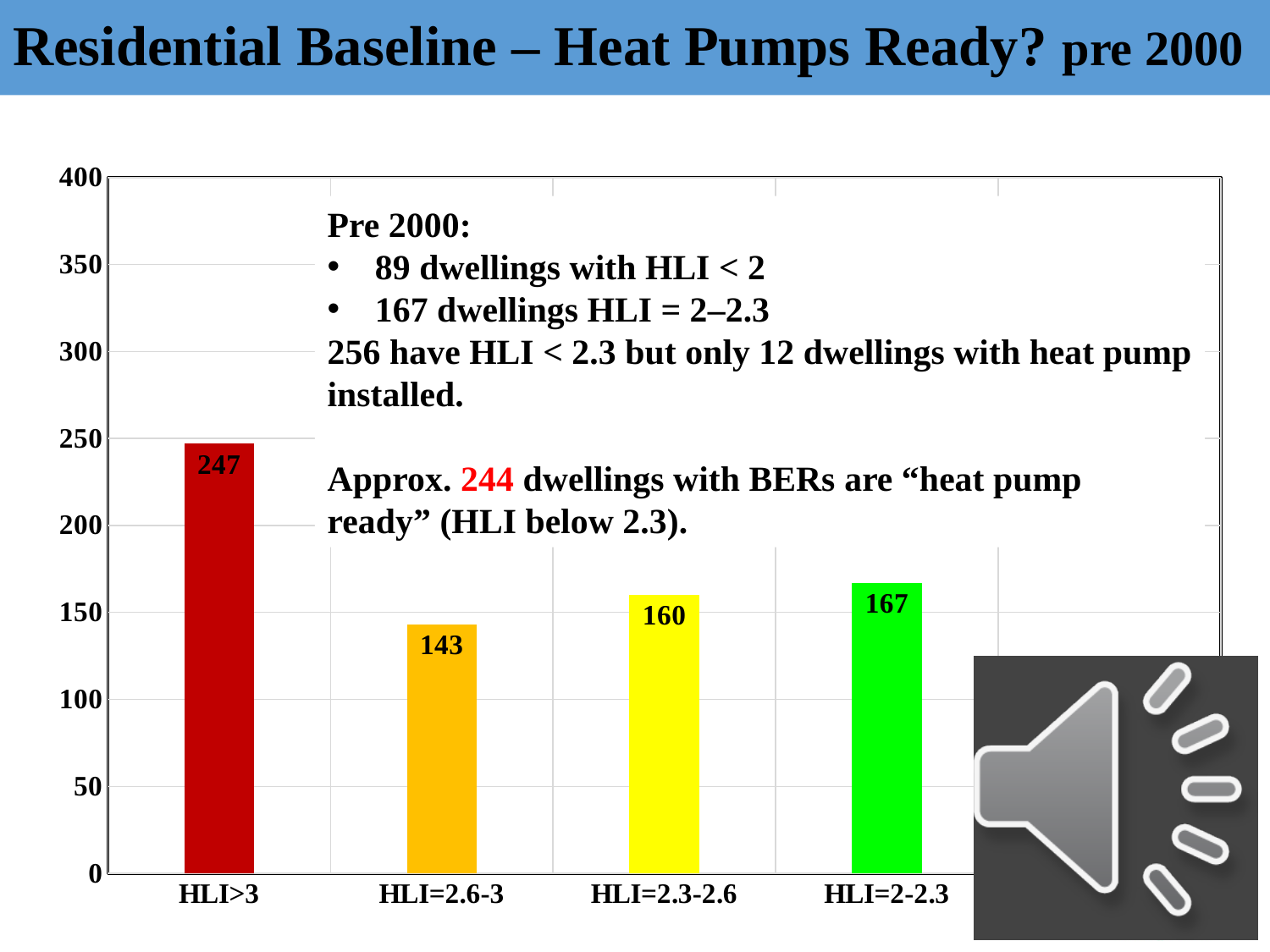
What is the value for HLI=2-2.3? 167 Which is larger, the value for HLI=2.6-3 or the value for HLI=2.3-2.6? HLI=2.3-2.6 Which category has the highest value? HLI>3 What kind of chart is shown on the slide? bar chart Is the value for HLI>3 greater or less than 200? greater What is the value for HLI=2.6-3? 143 What is the difference between the values for HLI=2-2.3 and HLI=2.3-2.6? 7 What colour is the bar for HLI=2-2.3? green What is the difference between the values for HLI>3 and HLI=2.6-3? 104 What is the value for HLI=2.3-2.6? 160 Is the value for HLI=2.6-3 greater or less than 150? less What is the value for HLI>3? 247